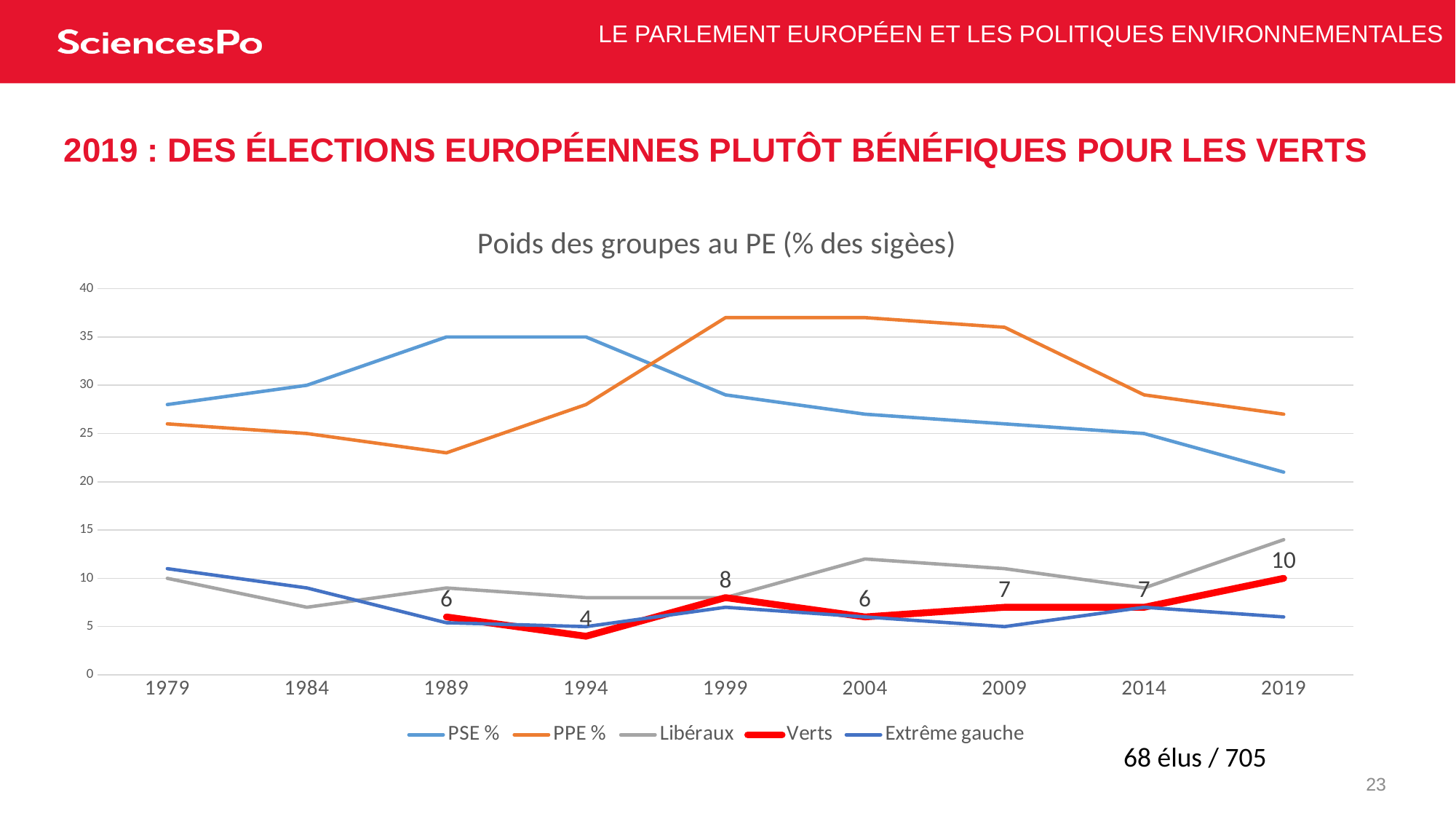
In which year does the Verts series reach its highest value? 2019 How many election years are plotted along the x axis? 9 What kind of chart is shown on the slide? line chart Which series has the larger value in 1989, PSE % or PPE %? PSE % Is the value for PSE % in 2019 greater or less than 25? less What is the value for Verts in 1994? 4 What is the value for Verts in 2019? 10 What is the difference between the Verts value in 2019 and in 1994? 6 Does the PSE % series rise or fall from 1989 to 2019? fall In which year does the Verts series reach its lowest value? 1994 Is the value for PPE % in 1999 greater or less than 35? greater How many series does the legend list? 5